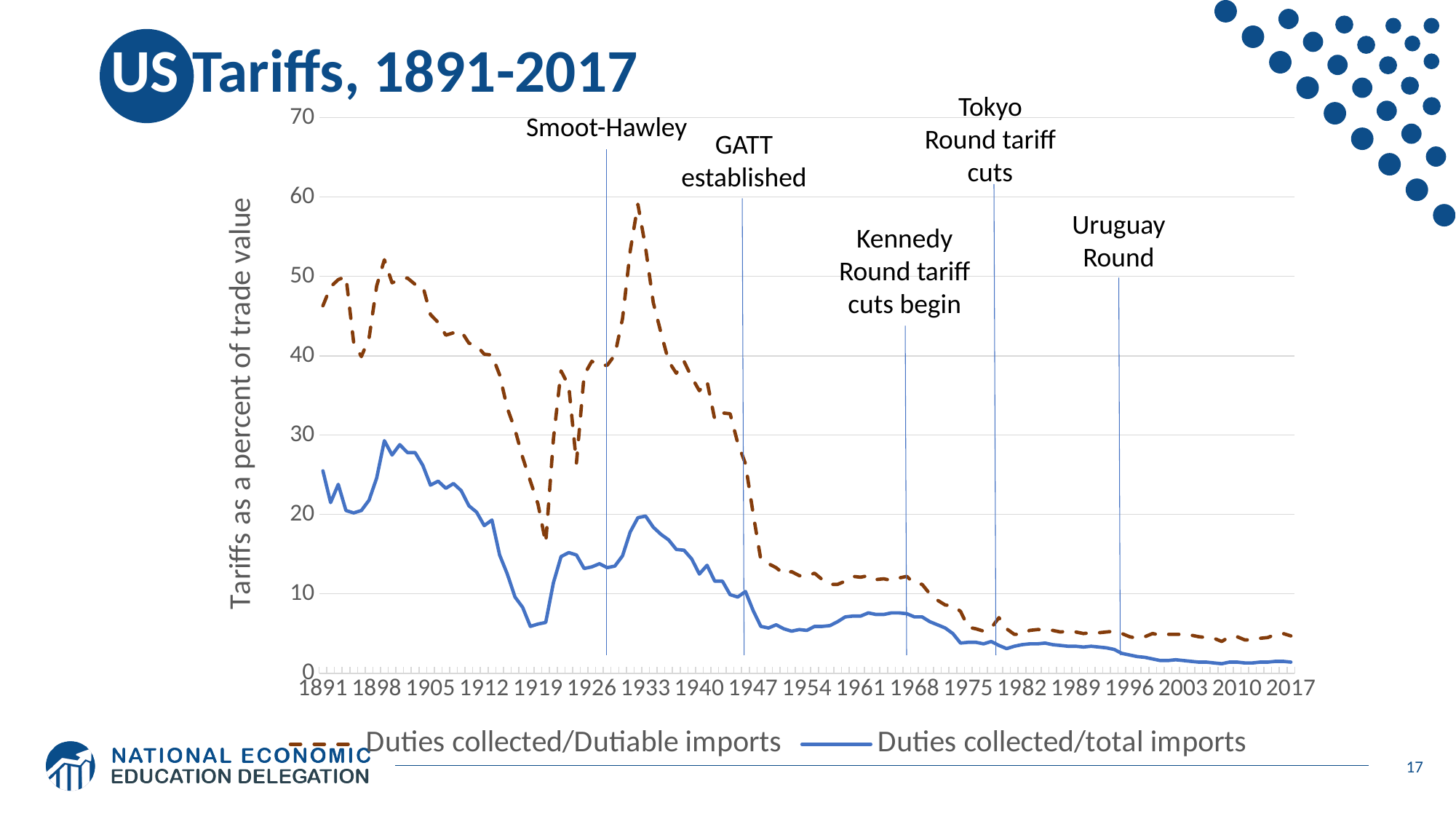
Is the value for Duties collected/total imports in 2017 greater or less than 10? less Is the value for Duties collected/Dutiable imports in 2017 greater or less than 10? less Is the peak value of Duties collected/Dutiable imports around 1932 greater or less than 50? greater What kind of chart is shown on the slide? line chart What is the title of the y axis? Tariffs as a percent of trade value Does the Duties collected/total imports line rise or fall from 1947 to 2017? fall Which series is drawn with a dashed line? Duties collected/Dutiable imports In 1933, which series has the higher value: Duties collected/Dutiable imports or Duties collected/total imports? Duties collected/Dutiable imports Which series reaches the highest value on the chart? Duties collected/Dutiable imports How many series does the legend list? 2